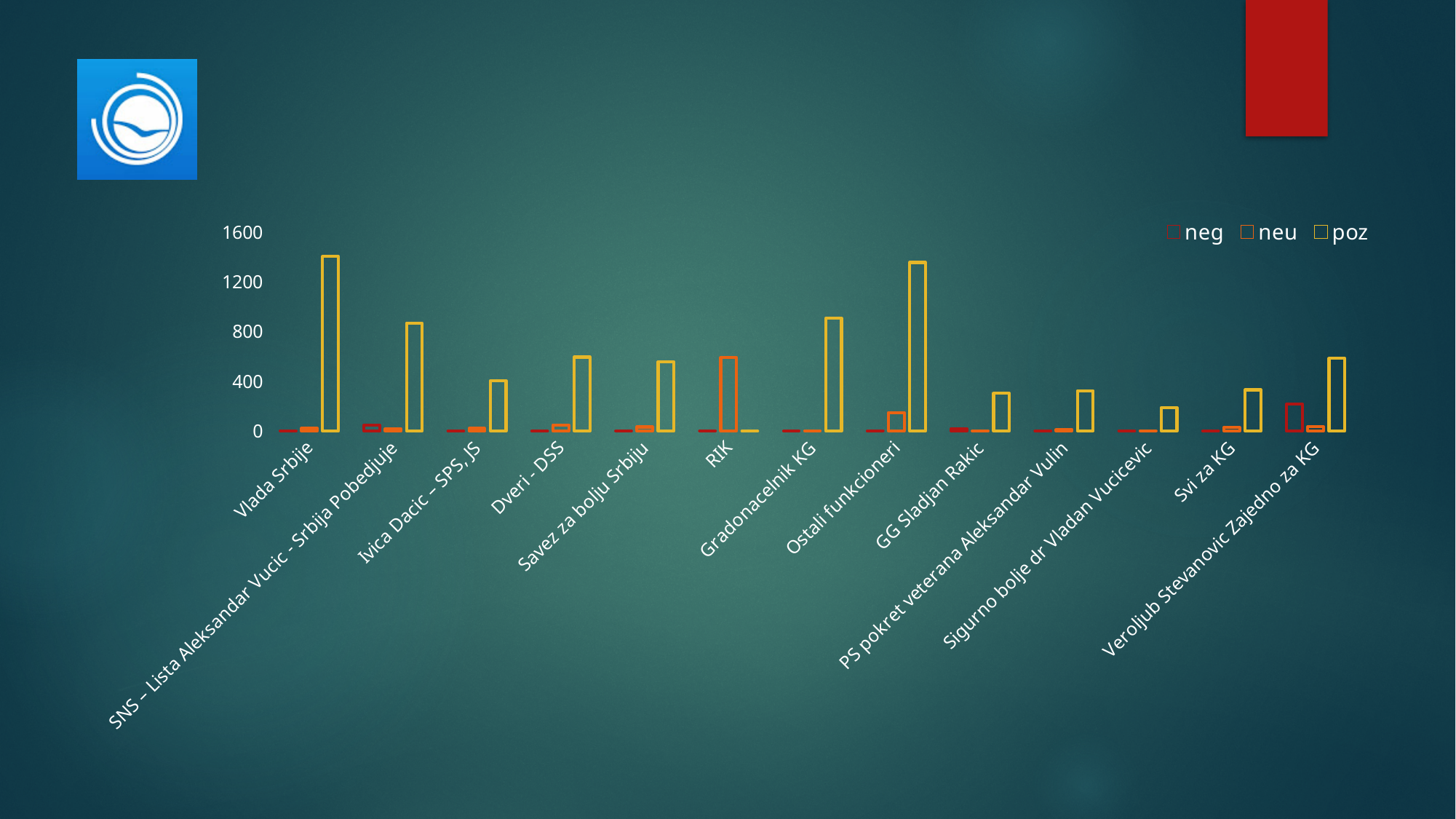
Is the poz value for Ostali funkcioneri greater or less than 1200? greater Which category has the highest neg value? Veroljub Stevanovic Zajedno za KG Is the poz value for Vlada Srbije greater or less than 1200? greater Is the poz value for Sigurno bolje dr Vladan Vucicevic greater or less than 400? less Which has the larger poz value, SNS – Lista Aleksandar Vucic - Srbija Pobedjuje or Ivica Dacic – SPS, JS? SNS – Lista Aleksandar Vucic - Srbija Pobedjuje How many categories are shown on the x axis? 13 Which category has the highest neu value? RIK What are the names of the three series in the legend? neg, neu, poz How many series does the legend list? 3 What kind of chart is shown on the slide? bar chart